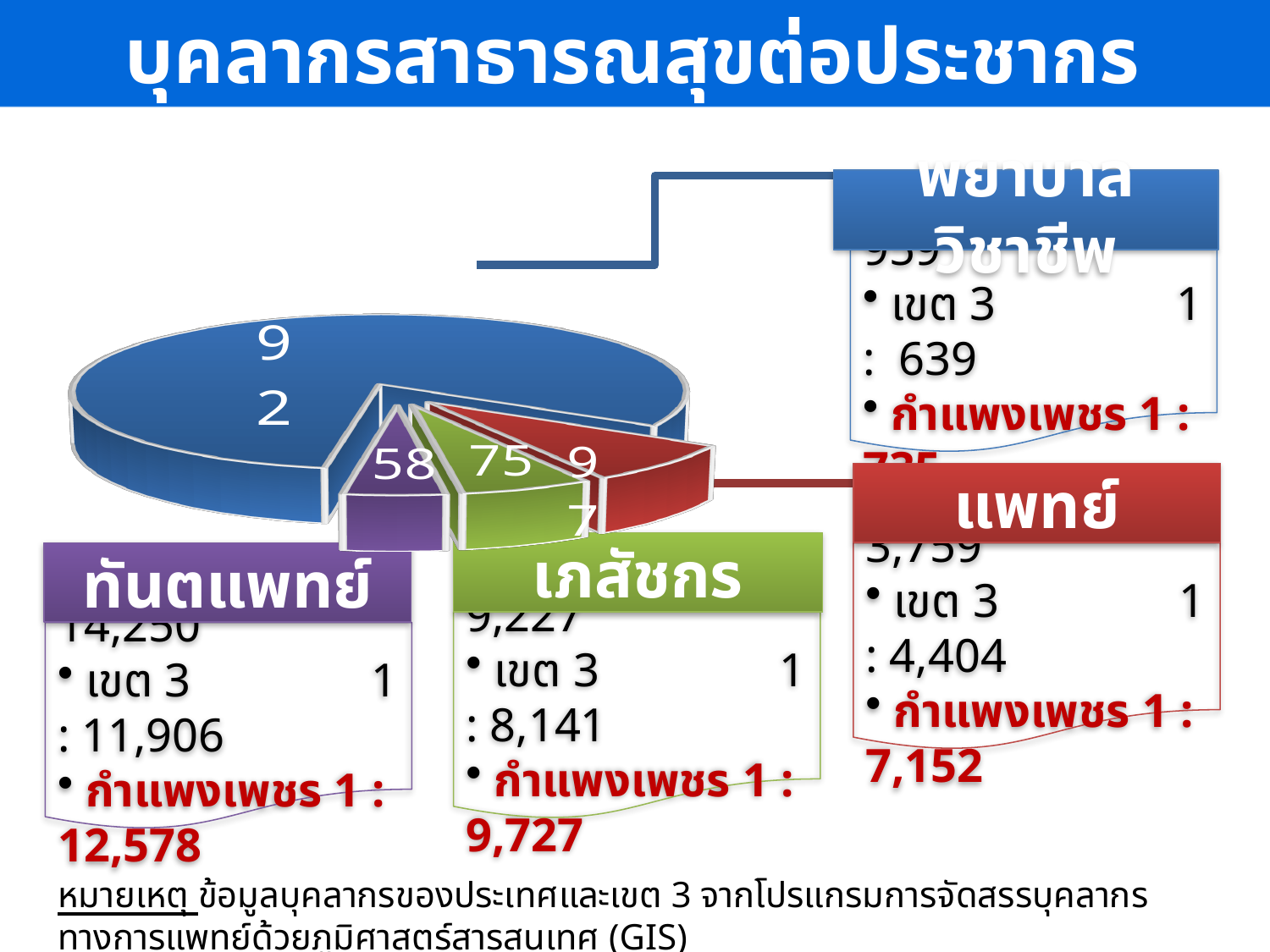
Which slice of the pie chart has the lowest value? ทันตแพทย์ (purple, 58) Which is larger in the pie chart, the green slice (เภสัชกร) or the purple slice (ทันตแพทย์)? เภสัชกร (green) What value is printed on the green slice (เภสัชกร) of the pie chart? 75 What is the difference between the red slice (97) and the purple slice (58) in the pie chart? 39 What value is printed on the red slice (แพทย์) of the pie chart? 97 How many slices does the pie chart have? 4 What value is printed on the purple slice (ทันตแพทย์) of the pie chart? 58 Which slice of the pie chart has the highest value? พยาบาลวิชาชีพ (blue) What kind of chart is shown on the slide? Pie chart What colour is the slice representing แพทย์ in the pie chart? Red